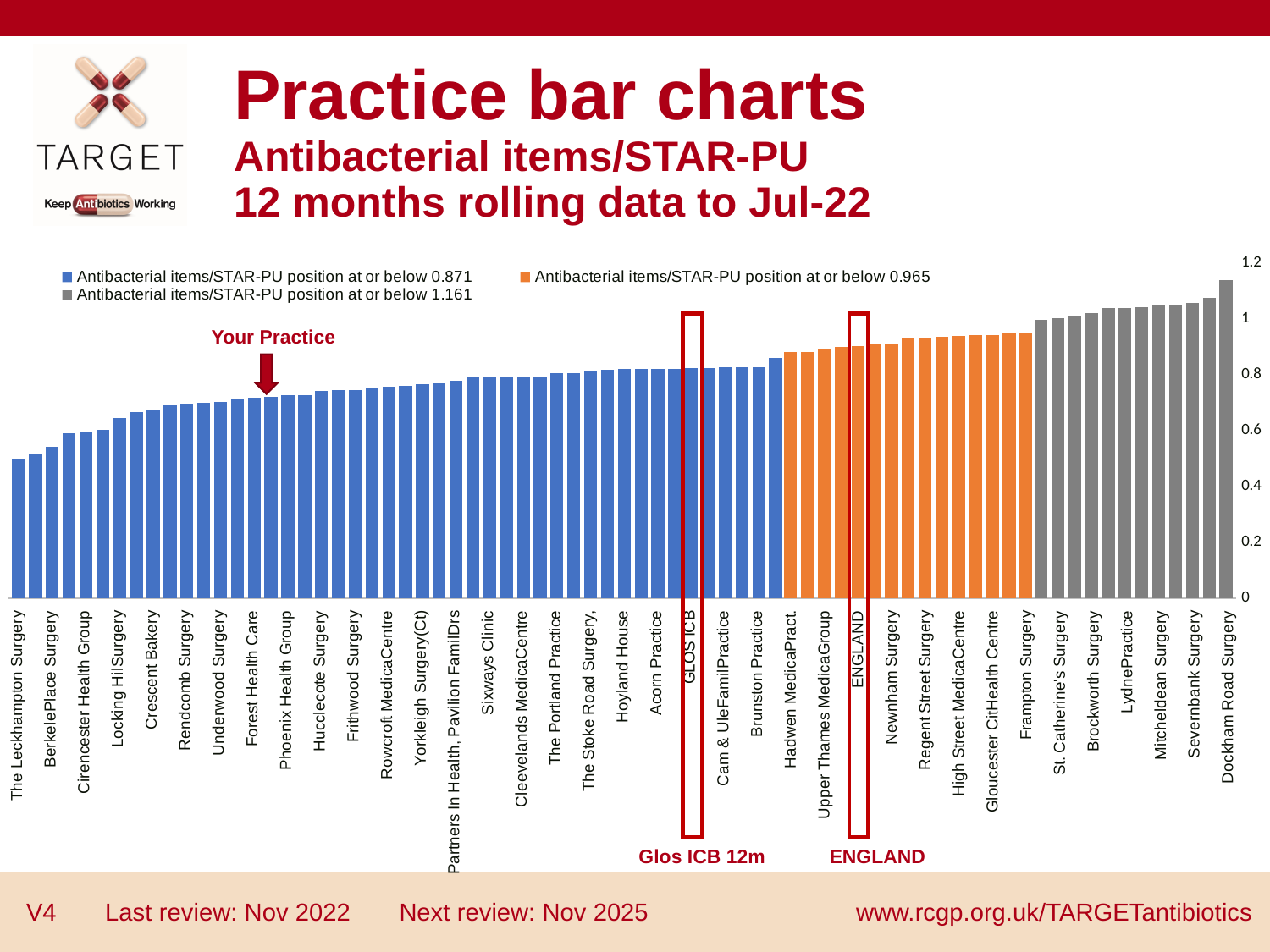
Which practice has the lowest value on the chart? The Leckhampton Surgery Which practice has the highest value on the chart? Dockham Road Surgery How many series does the legend list? 3 Do the bar values rise or fall from left to right along the x axis? rise What kind of chart is shown on the slide? bar chart Which is larger, the value for Frampton Surgery or the value for Acorn Practice? Frampton Surgery Which legend entry is shown in orange? Antibacterial items/STAR-PU position at or below 0.965 Is the value for ENGLAND greater or less than 0.8? greater Which is larger, the value for ENGLAND or the value for GLOS ICB? ENGLAND Is the value for Dockham Road Surgery greater or less than 1? greater Is the value for The Leckhampton Surgery greater or less than 0.6? less